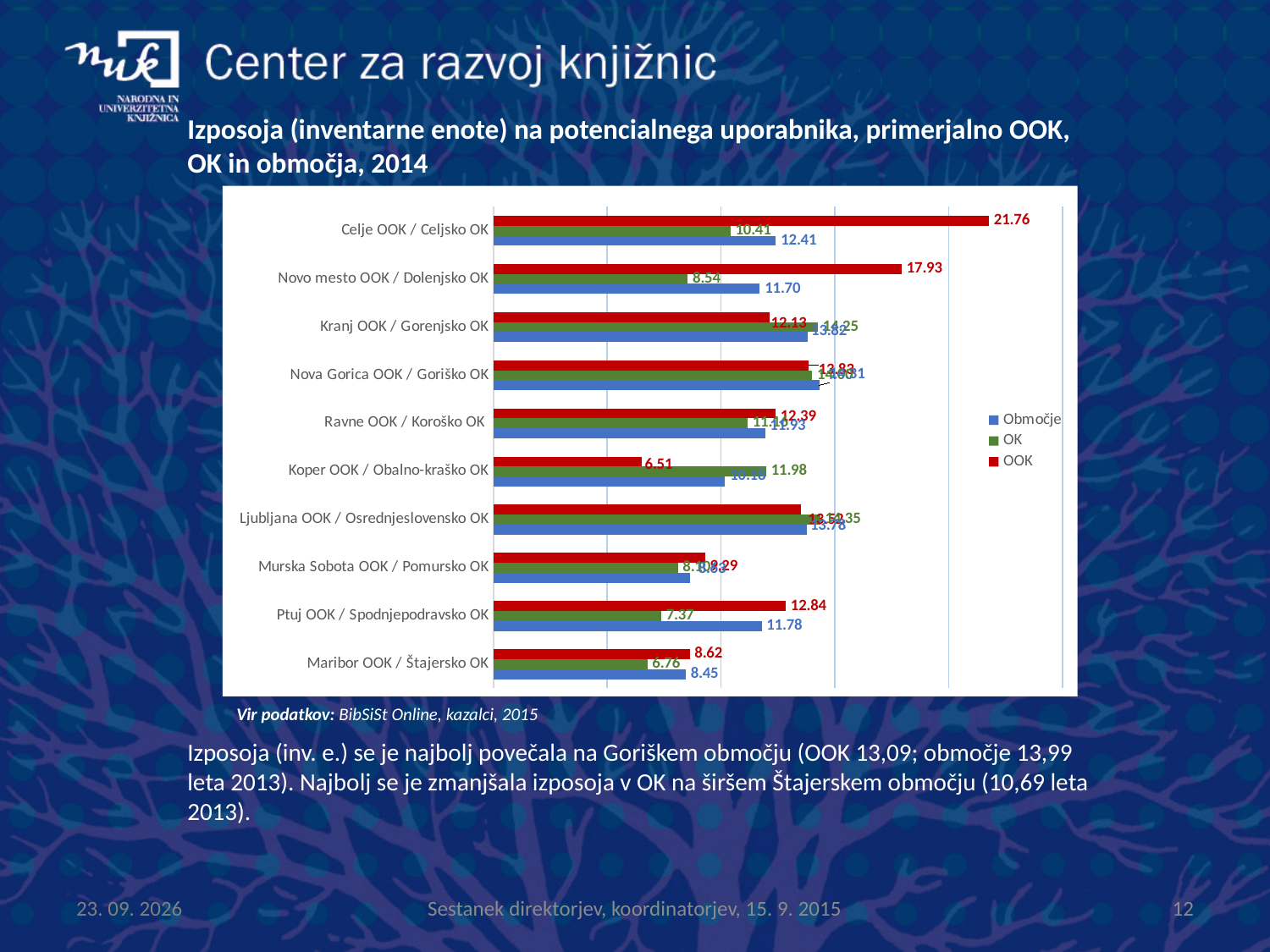
How many categories are shown on the chart? 10 What is the OOK value for Celje OOK / Celjsko OK? 21.76 What is the difference between the OOK and Območje values for Celje OOK / Celjsko OK? 9.35 What is the OK value for Maribor OOK / Štajersko OK? 6.76 Which category has the lowest OOK value? Koper OOK / Obalno-kraško OK What is the difference between the OOK and OK values for Novo mesto OOK / Dolenjsko OK? 9.39 What kind of chart is shown on the slide? Bar chart What is the OK value for Ptuj OOK / Spodnjepodravsko OK? 7.37 For Ptuj OOK / Spodnjepodravsko OK, which is larger: the OOK value or the OK value? OOK Which category has the highest OOK value? Celje OOK / Celjsko OK How many series does the legend list? 3 What is the Območje value for Novo mesto OOK / Dolenjsko OK? 11.70